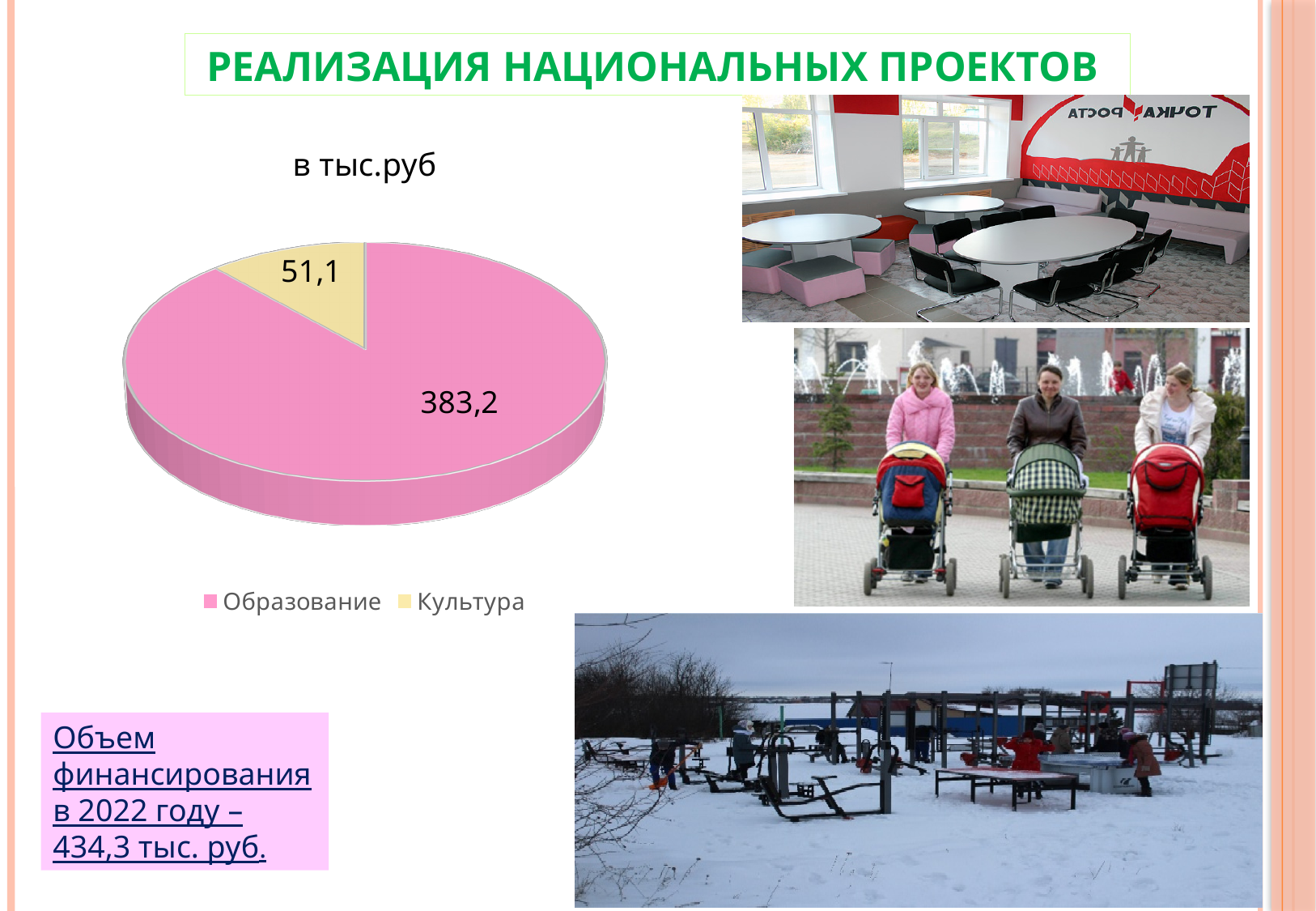
What is the title shown above the pie chart? в тыс.руб What type of chart is shown on the slide? Pie chart How many categories does the pie chart show? 2 Which category has the largest slice in the pie chart? Образование Which category has the smallest slice in the pie chart? Культура Which is larger, the value for Образование or the value for Культура? Образование What colour is the Культура slice in the pie chart? Yellow What is the total of the two values shown in the pie chart? 434,3 What is the difference between the values for Образование and Культура? 332,1 What is the value for Культура in the pie chart? 51,1 What is the value for Образование in the pie chart? 383,2 How many entries does the legend of the pie chart list? 2